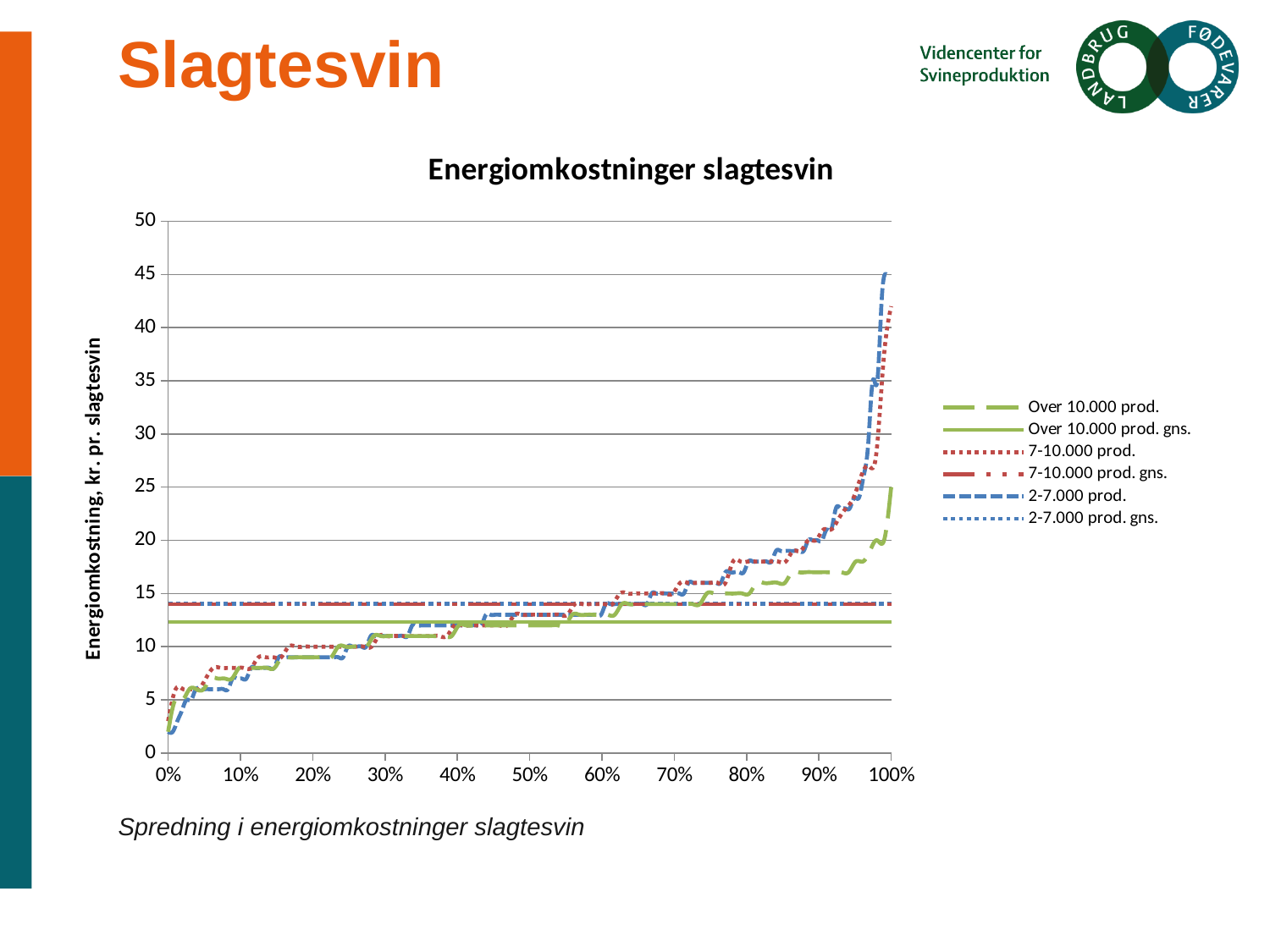
Is the value of the '2-7.000 prod.' series at 100% greater or less than 40? greater What is the label of the vertical axis of the chart? Energiomkostning, kr. pr. slagtesvin What kind of chart is shown on the slide? line chart What is the highest value shown on the vertical axis of the chart? 50 Do the values of the '2-7.000 prod.' series rise or fall as the x axis goes from 0% to 100%? rise How many series does the legend of the chart list? 6 Is the value of the '7-10.000 prod. gns.' line greater or less than 10? greater Is the value of the 'Over 10.000 prod.' series at 100% greater or less than 20? greater At 100%, which series has the higher value: '2-7.000 prod.' or 'Over 10.000 prod.'? 2-7.000 prod. Which average line is higher: 'Over 10.000 prod. gns.' or '7-10.000 prod. gns.'? 7-10.000 prod. gns. What is the title of the chart? Energiomkostninger slagtesvin